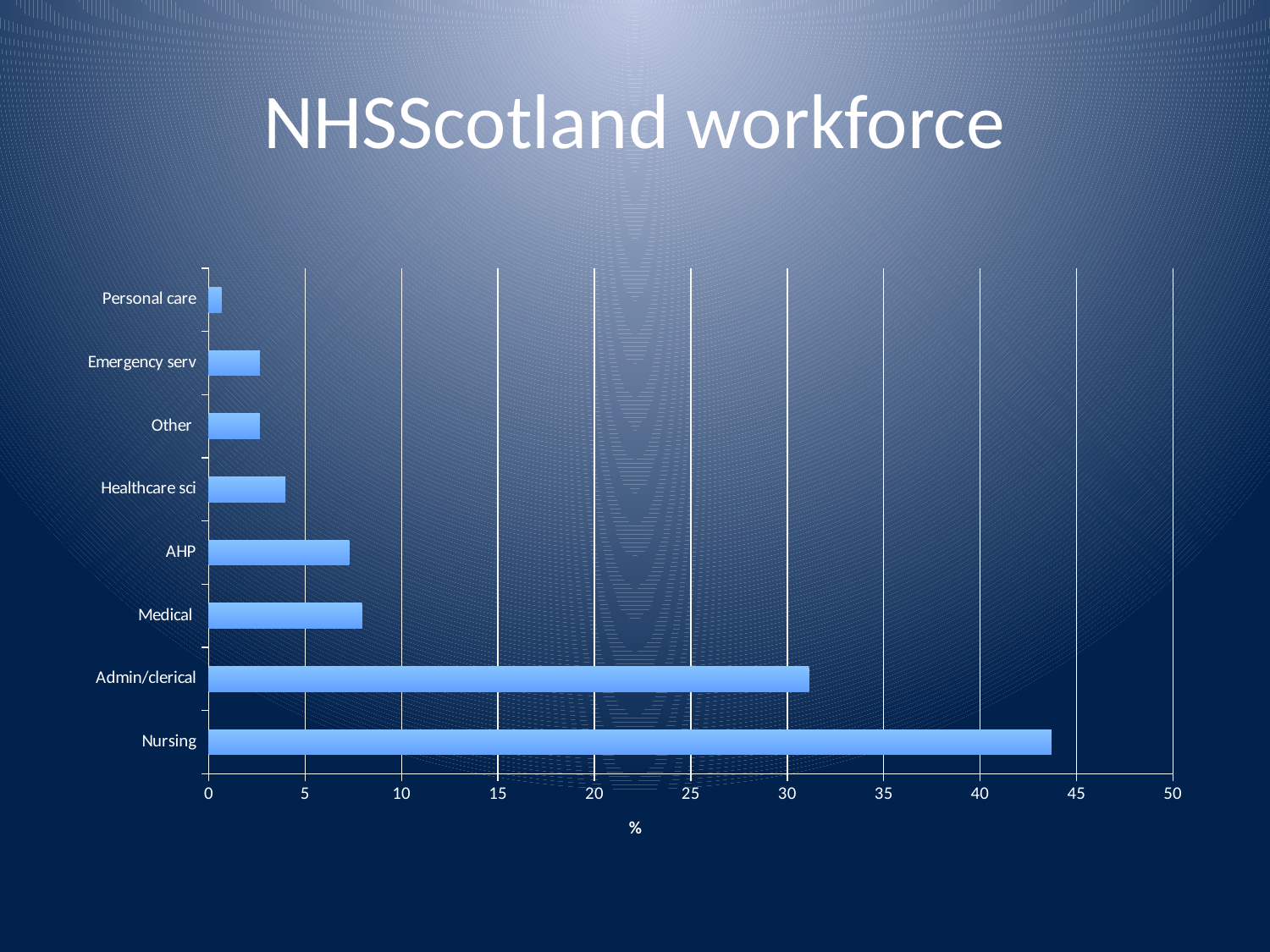
Is the value for Medical greater or less than 10? less Which is larger, the value for Medical or the value for Healthcare sci? Medical Is the value for Healthcare sci greater or less than 5? less Which category has the lowest value? Personal care Is the value for Admin/clerical greater or less than 30? greater Which is larger, the value for Nursing or the value for Admin/clerical? Nursing How many categories are shown in the chart? 8 What is the title of the chart? NHSScotland workforce Which category has the highest value? Nursing What kind of chart is shown on the slide? bar chart